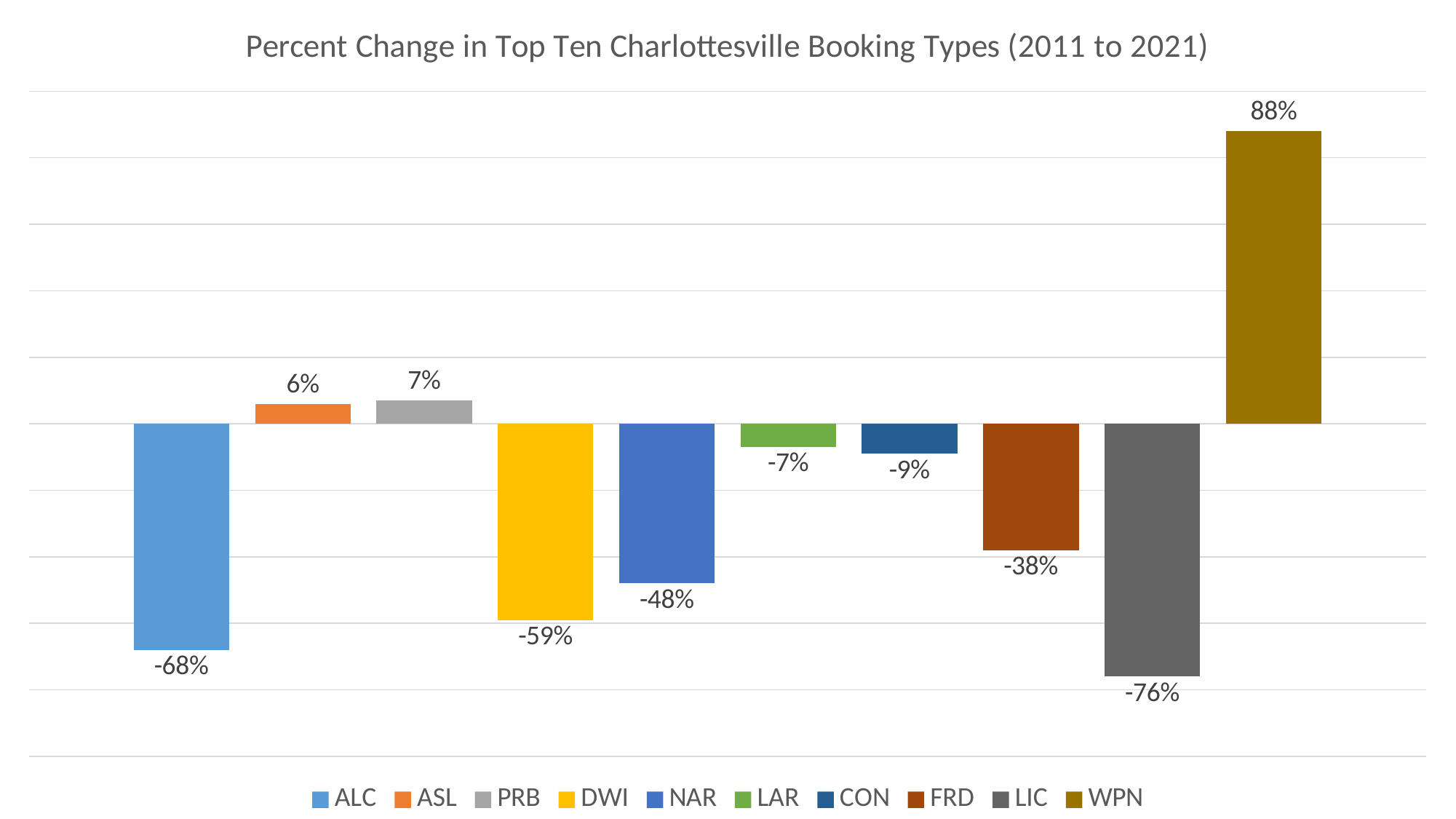
How many booking types are shown in the chart? 10 What is the difference between the percent change for NAR and FRD? 10% What is the difference between the percent change for PRB and ASL? 1% What is the title of the chart? Percent Change in Top Ten Charlottesville Booking Types (2011 to 2021) What is the percent change for LAR? -7% Which booking type has the highest percent change? WPN Which has a larger percent change, ALC or NAR? NAR Which booking type has the lowest percent change? LIC How many entries does the legend list? 10 What is the percent change for WPN? 88% What is the percent change for DWI? -59% What kind of chart is shown on the slide? Bar chart